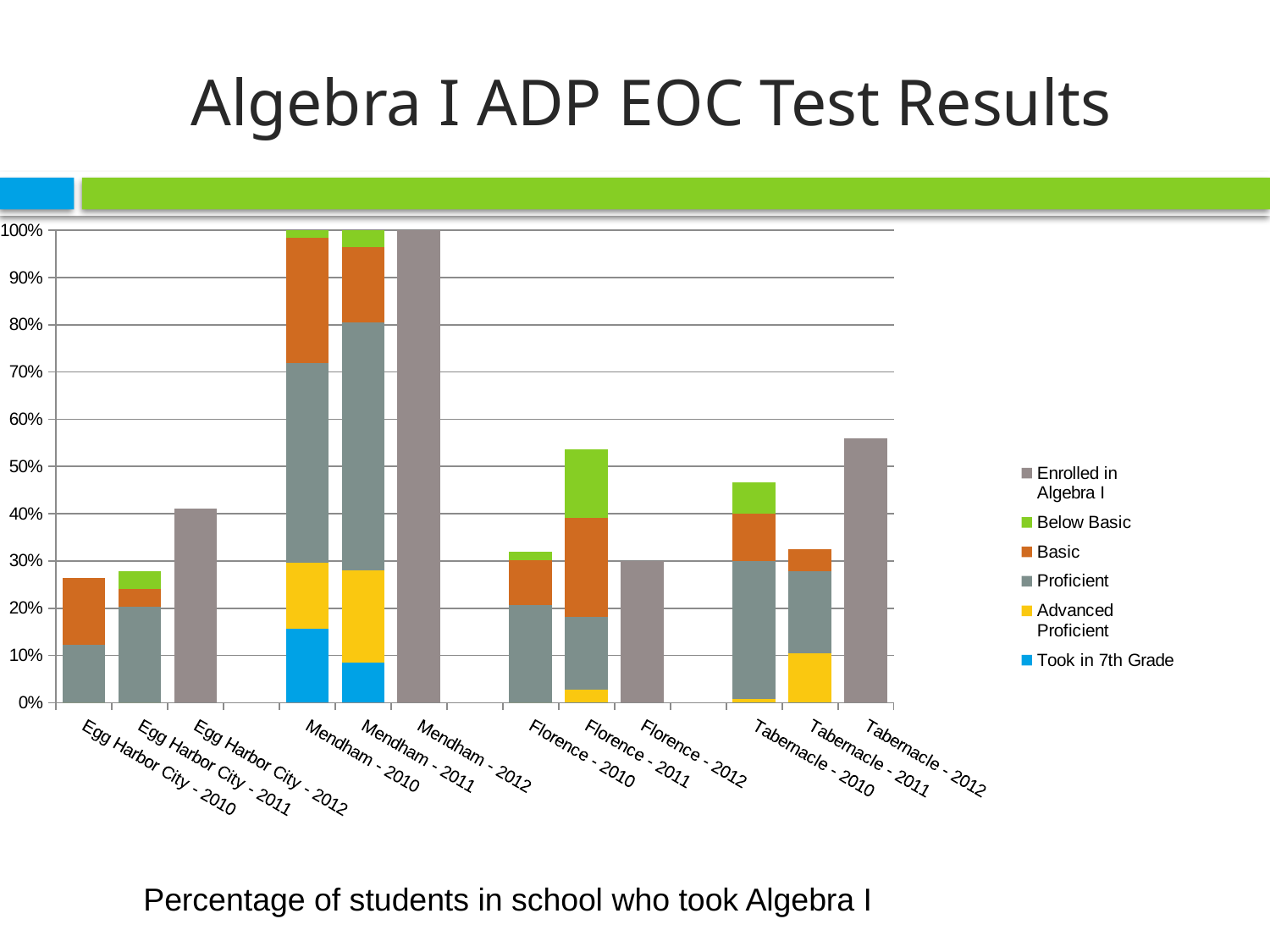
What kind of chart is shown on the slide? Stacked bar chart Is the total bar height for Egg Harbor City - 2012 greater or less than 50%? less What is the value of the bar for Mendham - 2012? 100% Is the bar for Tabernacle - 2012 greater or less than 50%? greater How many categories are shown along the x axis of the chart? 12 Which bar is taller, Tabernacle - 2012 or Egg Harbor City - 2012? Tabernacle - 2012 Which legend entry is shown in blue? Took in 7th Grade Is the total stacked bar for Egg Harbor City - 2010 greater or less than 30%? less How many series does the legend list? 6 What is the title of the slide containing the chart? Algebra I ADP EOC Test Results